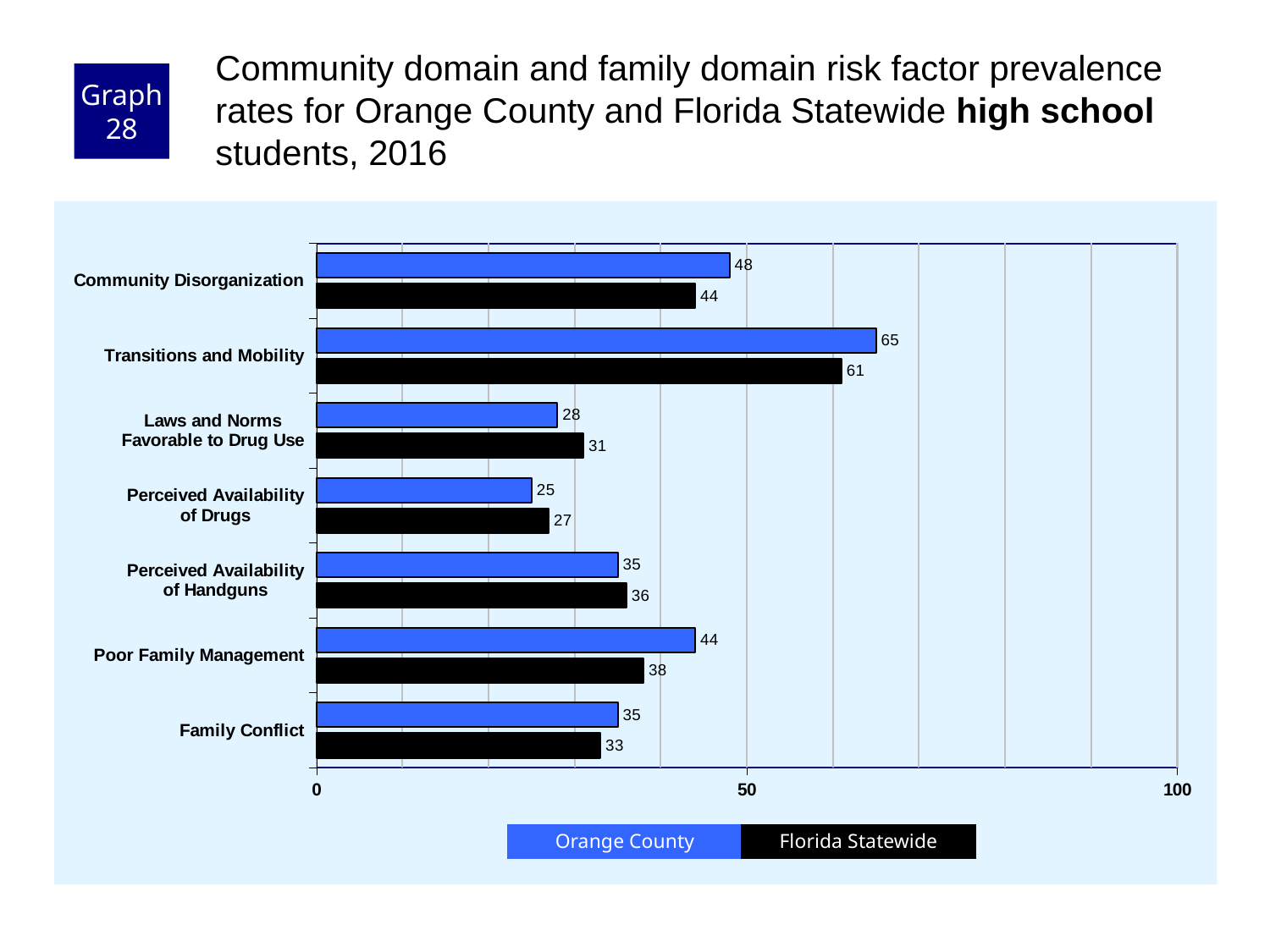
What is the Florida Statewide value for Poor Family Management? 38 Which risk factor has the highest Orange County value? Transitions and Mobility Which risk factor has the lowest Florida Statewide value? Perceived Availability of Drugs What is the difference between the Orange County and Florida Statewide values for Community Disorganization? 4 For Laws and Norms Favorable to Drug Use, which is larger: the Orange County value or the Florida Statewide value? Florida Statewide What kind of chart is shown on the slide? Bar chart What is the Florida Statewide value for Perceived Availability of Drugs? 27 How many risk factor categories are shown on the chart? 7 How many series does the legend list? 2 Which colour represents Florida Statewide in the chart? Black What is the Orange County value for Transitions and Mobility? 65 Is the Florida Statewide value for Transitions and Mobility greater or less than 50? greater